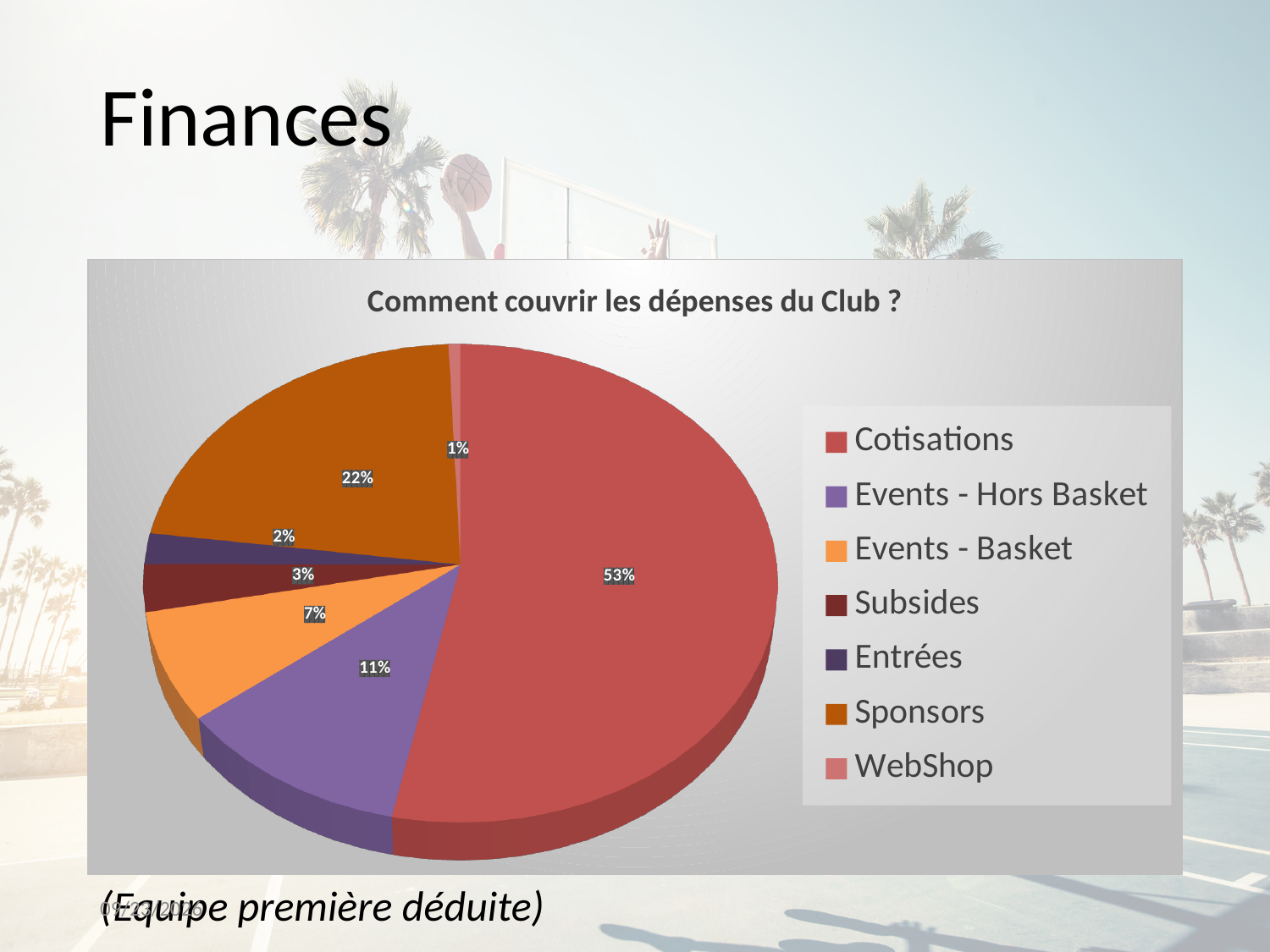
What share of the pie is Events - Hors Basket? 11% What is the difference in percentage points between Cotisations and Sponsors? 31 What kind of chart is shown on the slide? pie chart How many categories does the legend list? 7 What share of the pie is Events - Basket? 7% What is the title of the chart? Comment couvrir les dépenses du Club ? What share of the pie is Cotisations? 53% Which category has the smallest share of the pie? WebShop Which is larger, the share for Entrées or the share for Subsides? Subsides Which category has the largest share of the pie? Cotisations